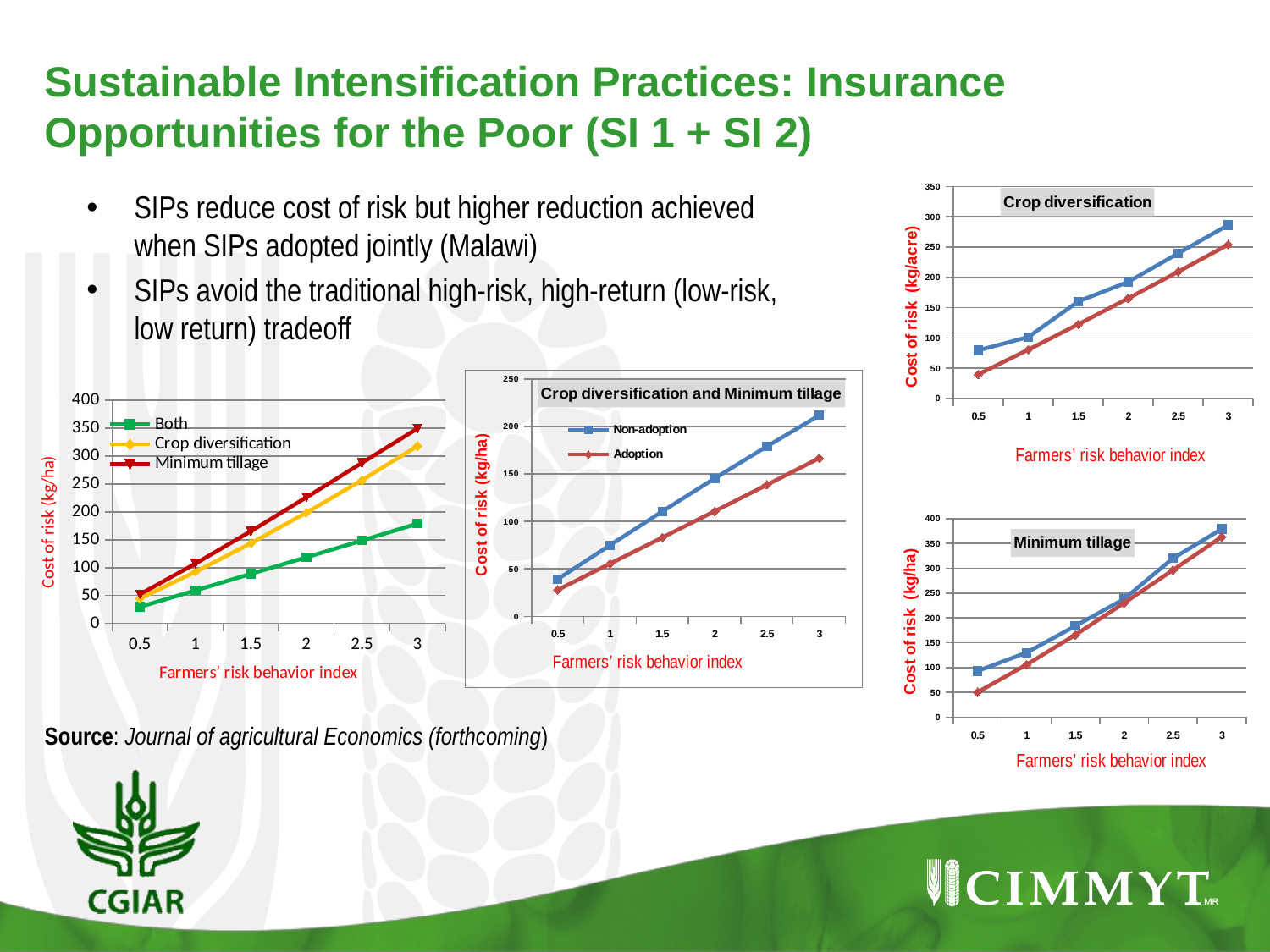
What kind of chart is the bottom-left chart with the legend Both, Crop diversification and Minimum tillage? Line chart In the chart titled 'Crop diversification and Minimum tillage', is the value for Non-adoption at a risk behavior index of 3 greater or less than 200? greater In the chart titled 'Crop diversification and Minimum tillage', which is larger at a risk behavior index of 3, Non-adoption or Adoption? Non-adoption In the bottom-left chart with the legend Both, Crop diversification and Minimum tillage, which series has the highest value at a risk behavior index of 3? Minimum tillage In the bottom-left chart with the legend Both, Crop diversification and Minimum tillage, do the values rise or fall as the farmers' risk behavior index increases? Rise In the chart titled 'Crop diversification and Minimum tillage', how many series does the legend list? 2 In the bottom-left chart with the legend Both, Crop diversification and Minimum tillage, which series has the lowest value at a risk behavior index of 3? Both In the bottom-left chart with the legend Both, Crop diversification and Minimum tillage, is the value for Both at a risk behavior index of 3 greater or less than 150? greater In the chart titled 'Minimum tillage' at the bottom right, is the value of the blue series at a risk behavior index of 3 greater or less than 350? greater In the bottom-left chart with the legend Both, Crop diversification and Minimum tillage, how many points are plotted along the x axis for each series? 6 In the bottom-left chart with the legend Both, Crop diversification and Minimum tillage, how many series does the legend list? 3